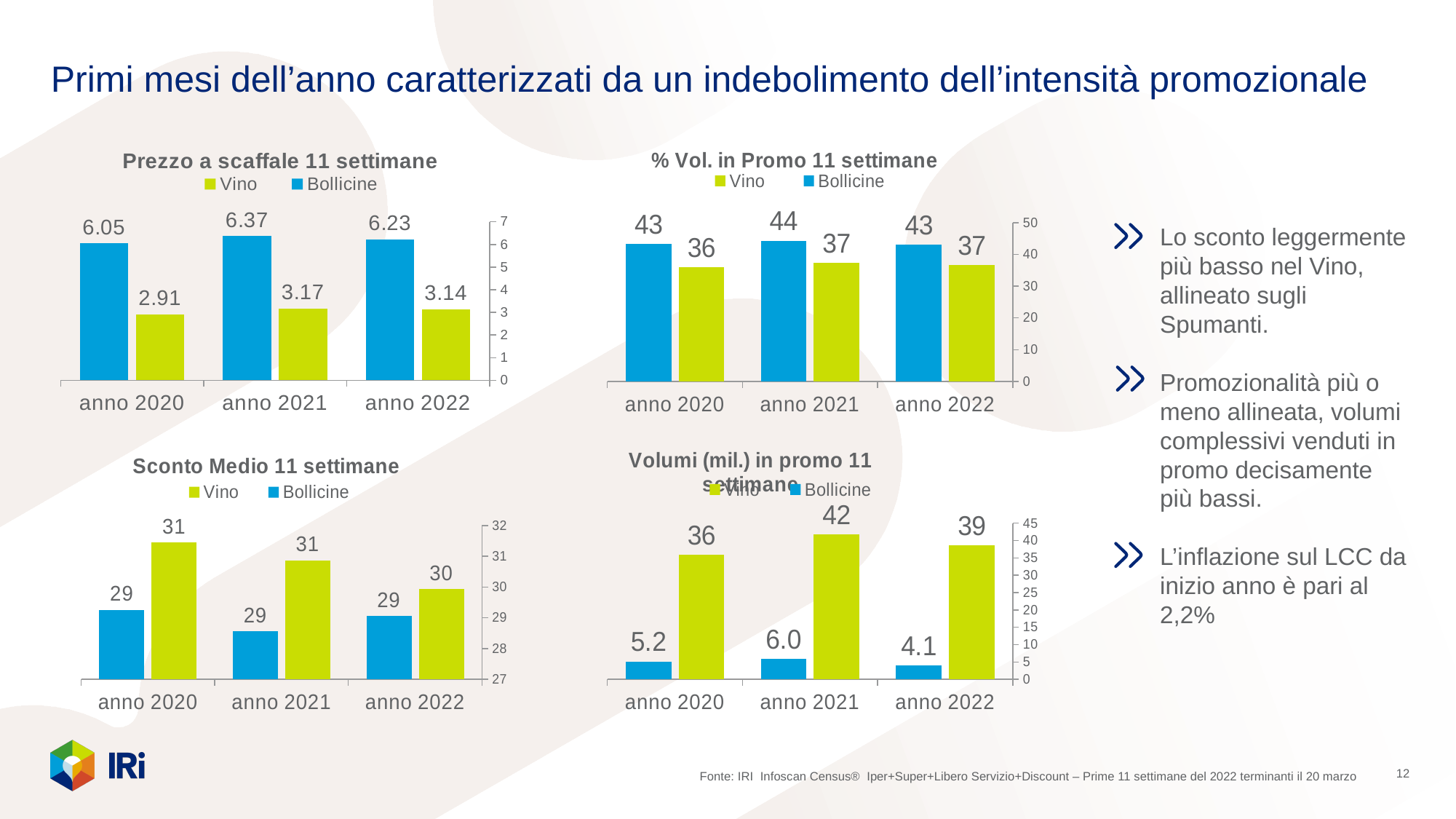
In the 'Volumi (mil.) in promo 11 settimane' chart, which year has the highest value for Vino? anno 2021 What kind of chart is the 'Prezzo a scaffale 11 settimane' chart? Bar chart In the '% Vol. in Promo 11 settimane' chart, what is the value for Vino in anno 2020? 36 In the '% Vol. in Promo 11 settimane' chart, which year has the highest value for Bollicine? anno 2021 In the 'Sconto Medio 11 settimane' chart, what is the value for Vino in anno 2022? 30 In the 'Prezzo a scaffale 11 settimane' chart, what is the difference between Bollicine and Vino in anno 2022? 3.09 In the 'Volumi (mil.) in promo 11 settimane' chart, what is the difference between Vino in anno 2021 and Vino in anno 2022? 3 In the 'Sconto Medio 11 settimane' chart, which series has the larger value in anno 2020, Vino or Bollicine? Vino In the 'Prezzo a scaffale 11 settimane' chart, what is the value for Bollicine in anno 2021? 6.37 In the 'Prezzo a scaffale 11 settimane' chart, what is the value for Vino in anno 2020? 2.91 How many series does the legend of the 'Sconto Medio 11 settimane' chart list? 2 In the 'Volumi (mil.) in promo 11 settimane' chart, what is the value for Bollicine in anno 2022? 4.1